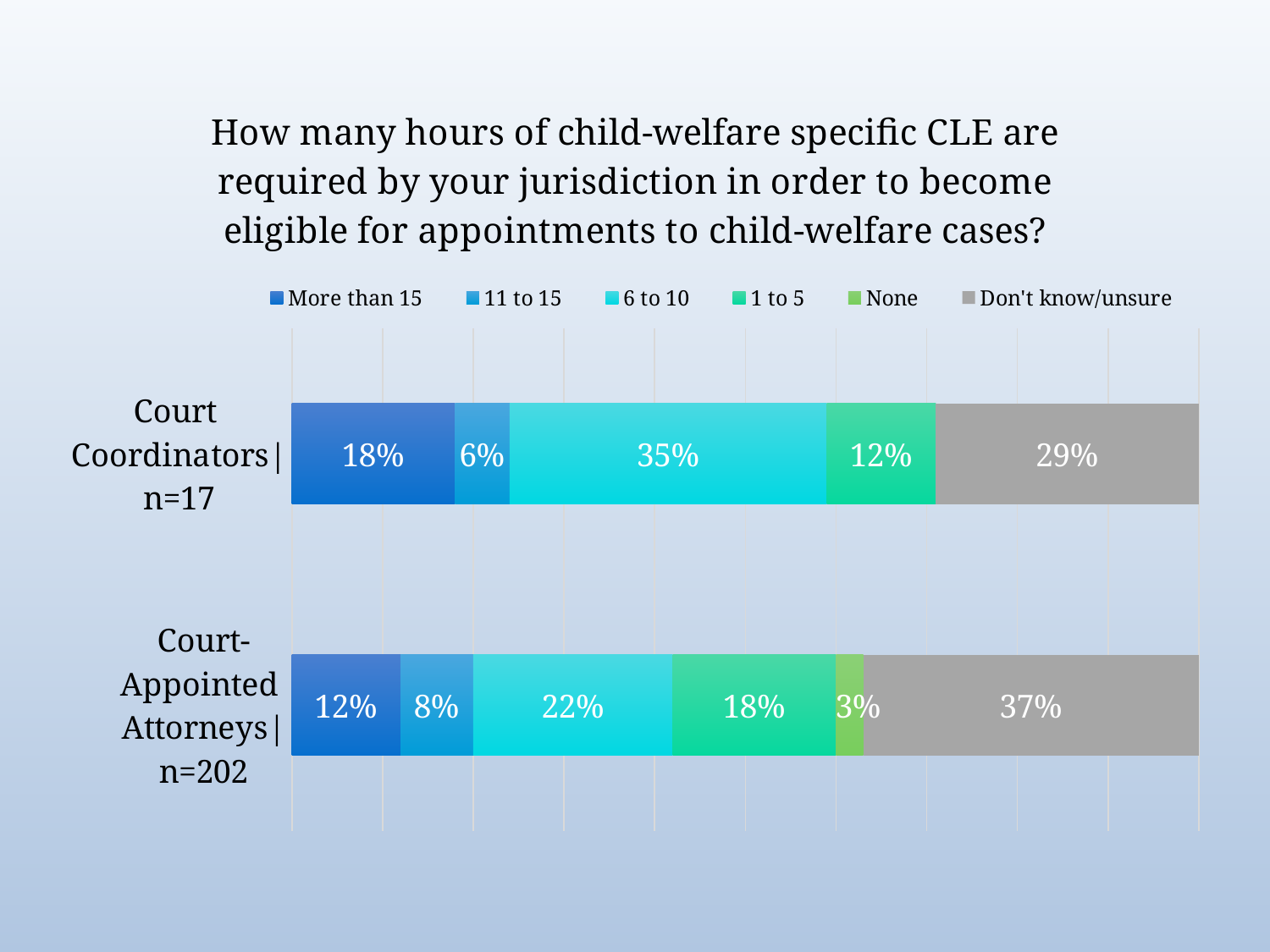
Which response category has the largest share among Court-Appointed Attorneys (n=202)? Don't know/unsure What percentage of Court Coordinators (n=17) reported that 6 to 10 hours of child-welfare specific CLE are required? 35% How many respondent groups are plotted on the chart? 2 Which group has a larger share answering 'Don't know/unsure': Court Coordinators (n=17) or Court-Appointed Attorneys (n=202)? Court-Appointed Attorneys What percentage of Court-Appointed Attorneys (n=202) answered 'Don't know/unsure'? 37% What percentage of Court Coordinators (n=17) reported that more than 15 hours are required? 18% What percentage of Court-Appointed Attorneys (n=202) reported that 1 to 5 hours are required? 18% What kind of chart is shown on the slide? Stacked bar chart Which response category has the largest share among Court Coordinators (n=17)? 6 to 10 What is the difference between the '6 to 10' share for Court Coordinators (n=17) and for Court-Appointed Attorneys (n=202)? 13 percentage points How many series does the legend list? 6 Which labelled response category has the smallest share among Court-Appointed Attorneys (n=202)? None